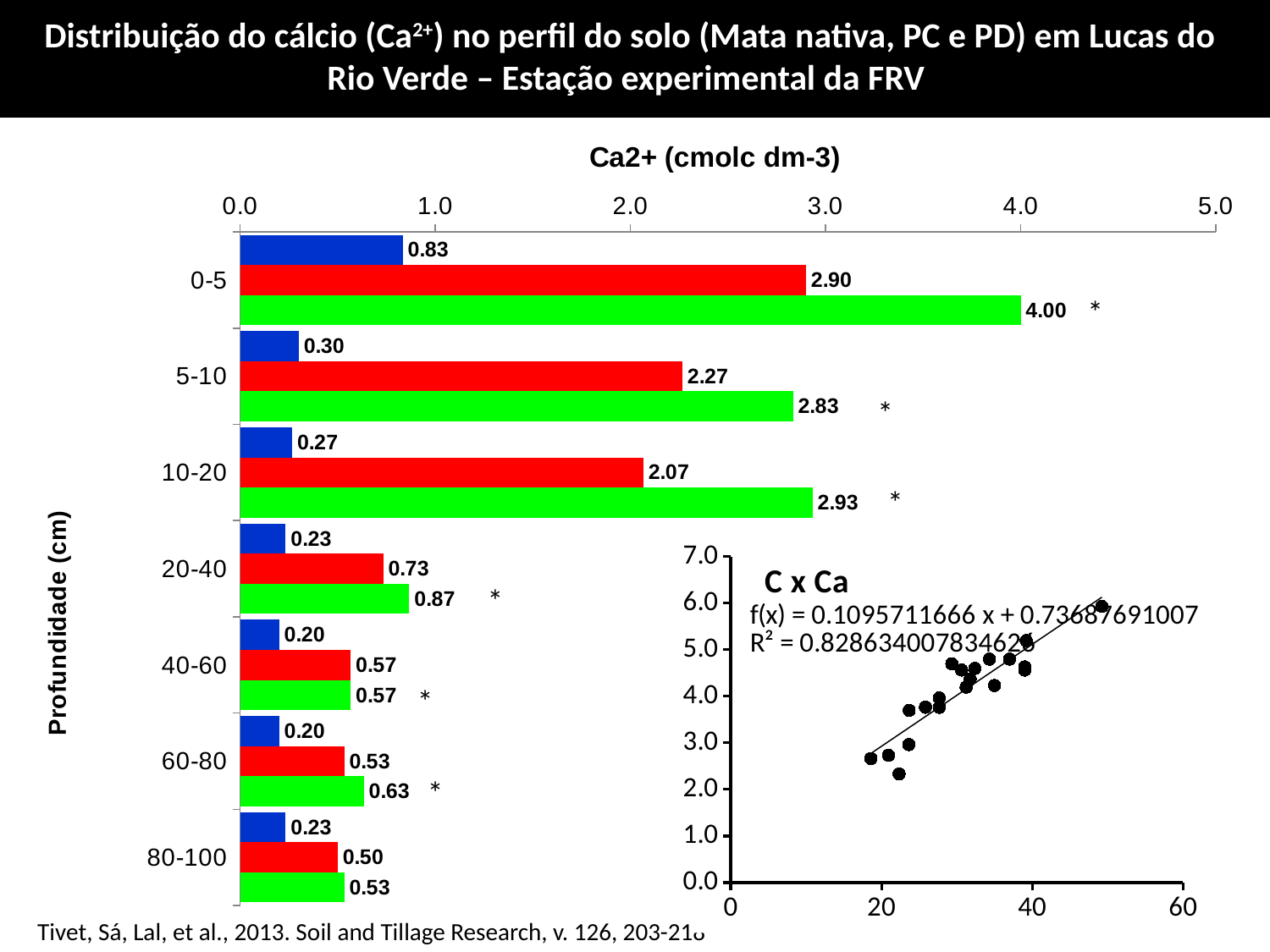
What is the title of the inset chart in the lower right of the slide? C x Ca In the bar chart on the left, at which depth is the green bar the highest? 0-5 In the bar chart on the left, what is the difference between the green bar and the red bar at the 0-5 cm depth? 1.10 What kind of chart is the inset chart in the lower right of the slide? scatter chart In the bar chart on the left, do the red bar values rise or fall as depth increases from 0-5 to 80-100 cm? fall What kind of chart is the large chart on the left of the slide? bar chart In the bar chart on the left, what is the value of the green bar for the 0-5 cm depth? 4.00 In the bar chart on the left, what is the value of the red bar for the 5-10 cm depth? 2.27 In the bar chart on the left, what is the value of the blue bar for the 10-20 cm depth? 0.27 In the bar chart on the left, which is larger: the blue bar at 0-5 cm or the blue bar at 5-10 cm? 0-5 cm In the bar chart on the left, how many depth categories are shown on the vertical axis? 7 In the bar chart on the left, at which depth is the red bar the lowest? 80-100